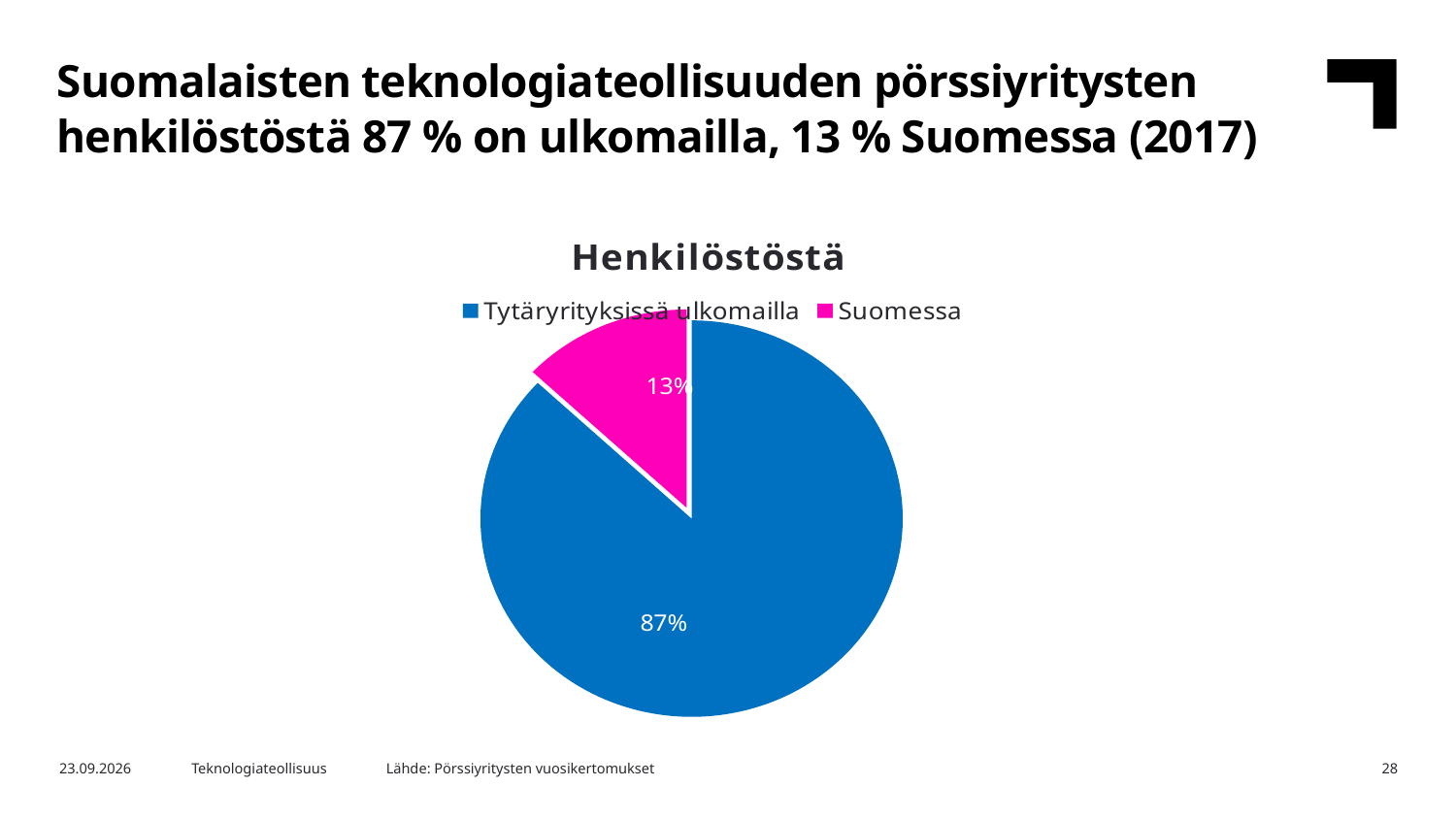
What share of the pie does "Tytäryrityksissä ulkomailla" represent? 87% What is the difference in percentage points between the "Tytäryrityksissä ulkomailla" slice and the "Suomessa" slice? 74 percentage points What is the title of the chart? Henkilöstöstä Which is larger, the share for "Suomessa" or the share for "Tytäryrityksissä ulkomailla"? Tytäryrityksissä ulkomailla What kind of chart is shown on the slide? Pie chart What colour is the "Suomessa" slice? Magenta (pink) How many slices does the pie chart have? 2 How many entries does the legend list? 2 What is the total of the two slices shown in the pie chart? 100% Which slice of the pie is the largest? Tytäryrityksissä ulkomailla Which slice of the pie is the smallest? Suomessa What share of the pie does "Suomessa" represent? 13%